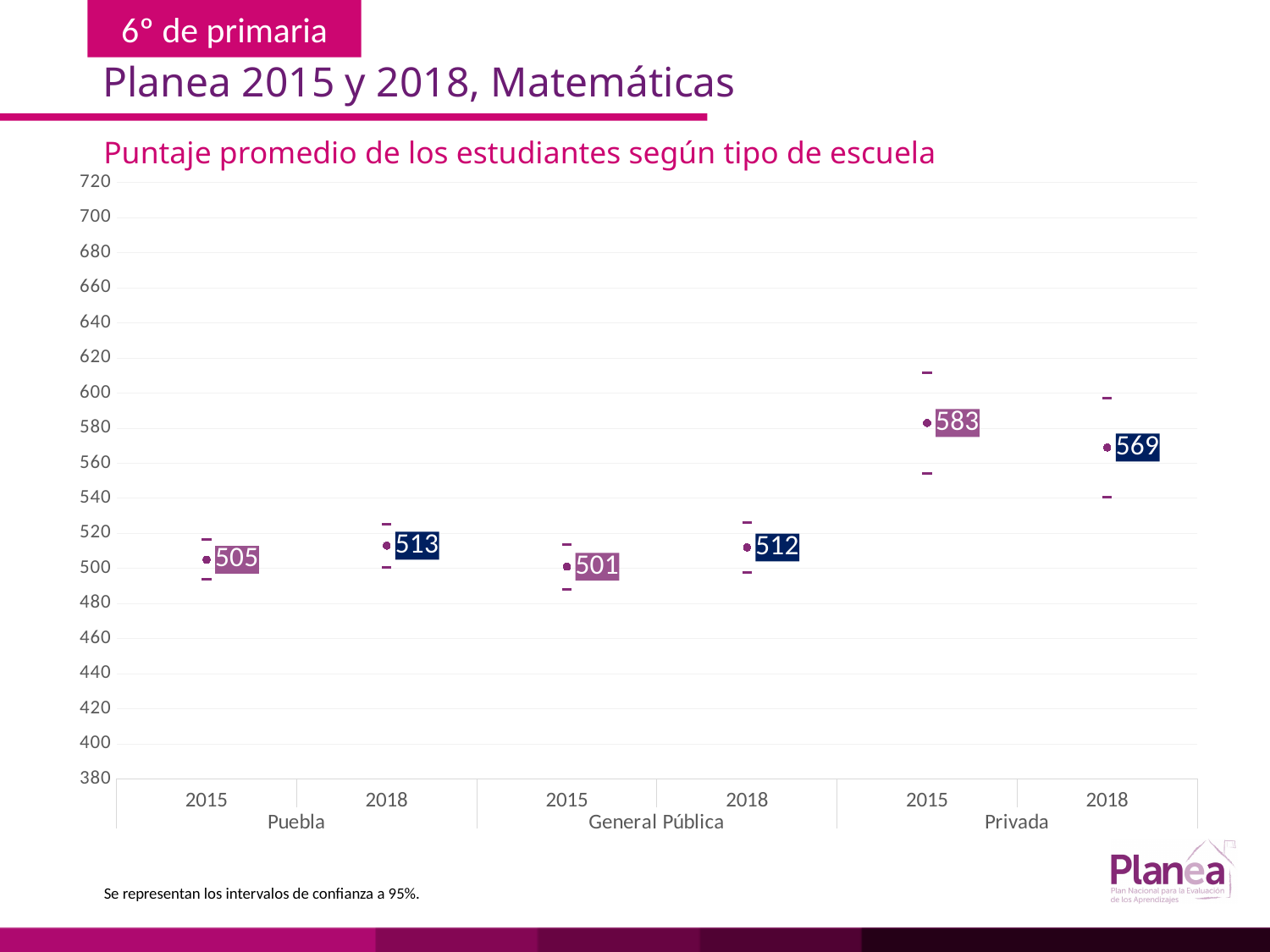
What is the difference between the Privada scores in 2015 and 2018? 14 What is the average score for Privada in 2018? 569 What is the title of the chart? Puntaje promedio de los estudiantes según tipo de escuela Did the Privada score rise or fall from 2015 to 2018? fall Which is larger, the 2018 score for Puebla or the 2018 score for General Pública? Puebla 2018 What is the average score for Puebla in 2018? 513 By how much did the Puebla score change from 2015 to 2018? 8 Which group and year has the lowest average score? General Pública 2015 What is the average score for Puebla in 2015? 505 How many data points are plotted on the chart? 6 What is the average score for General Pública in 2015? 501 Which group and year has the highest average score? Privada 2015